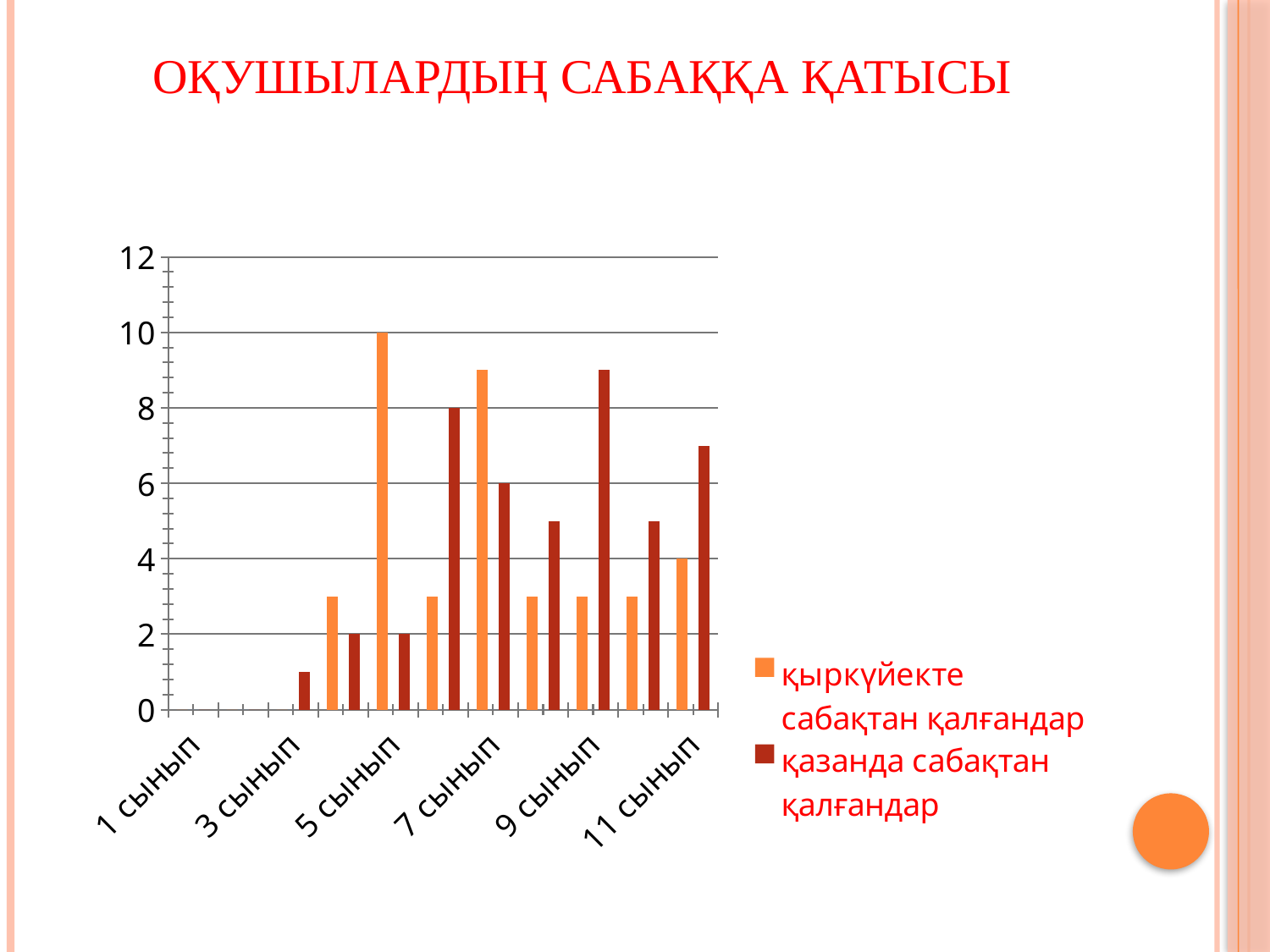
Is the value for 3 сынып in the қазанда сабақтан қалғандар series greater or less than 2? less What is the value for 5 сынып in the қыркүйекте сабақтан қалғандар series? 10 What is the title of the slide containing the chart? ОҚУШЫЛАРДЫҢ САБАҚҚА ҚАТЫСЫ Is the value for 11 сынып in the қазанда сабақтан қалғандар series greater or less than 6? greater What kind of chart is shown on the slide? bar chart How many series does the legend list? 2 For 9 сынып, which series has the larger value: қыркүйекте сабақтан қалғандар or қазанда сабақтан қалғандар? қазанда сабақтан қалғандар For 7 сынып, which series has the larger value: қыркүйекте сабақтан қалғандар or қазанда сабақтан қалғандар? қыркүйекте сабақтан қалғандар Which category has the highest value in the қазанда сабақтан қалғандар series? 9 сынып Which category has the highest value in the қыркүйекте сабақтан қалғандар series? 5 сынып What is the value for 7 сынып in the қазанда сабақтан қалғандар series? 6 What is the value for 11 сынып in the қыркүйекте сабақтан қалғандар series? 4